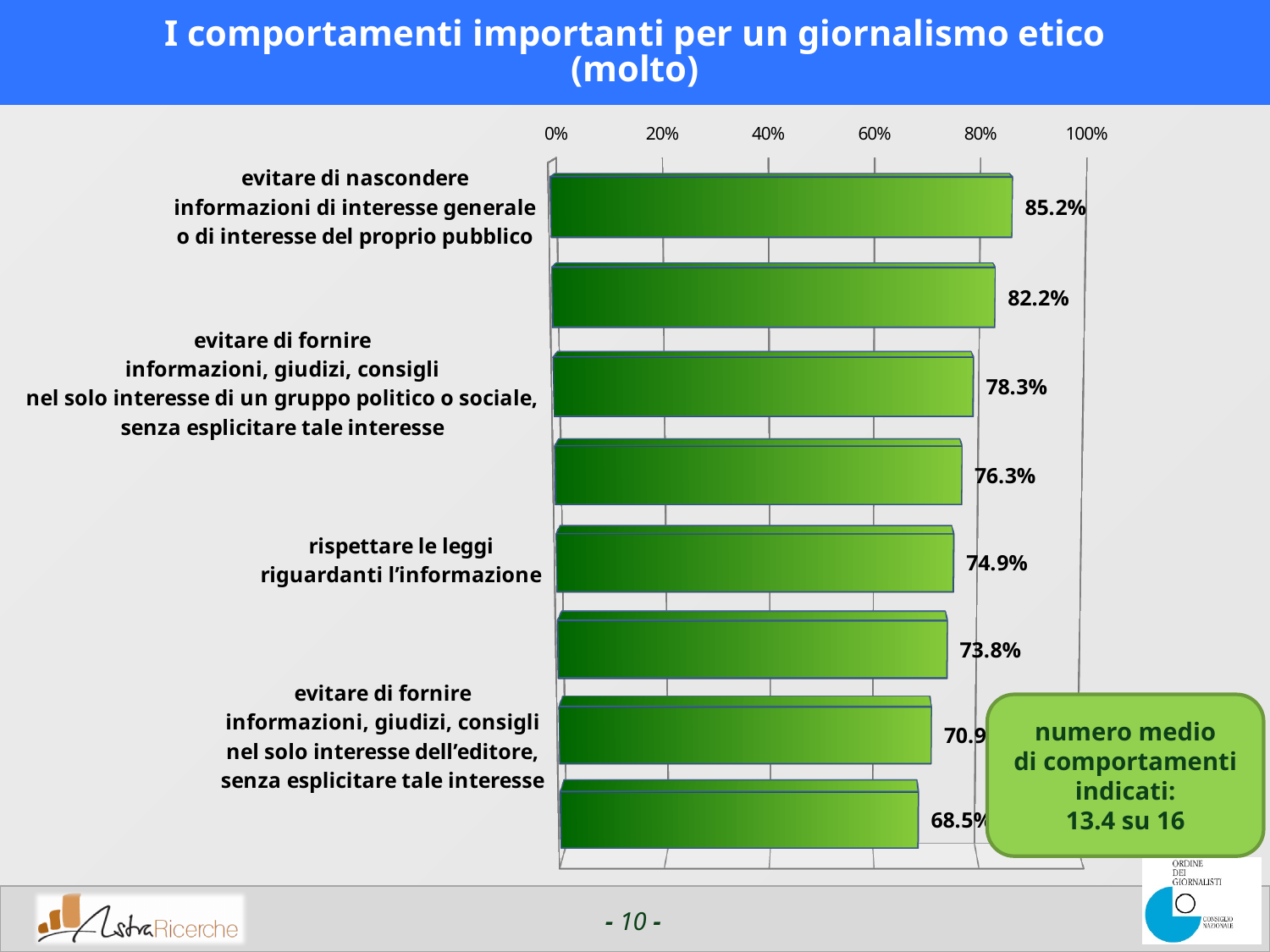
What percentage is shown for 'evitare di fornire informazioni, giudizi, consigli nel solo interesse dell'editore, senza esplicitare tale interesse'? 70.9% What percentage is shown for 'rispettare le leggi riguardanti l'informazione'? 74.9% Which is larger: the value for 'rispettare le leggi riguardanti l'informazione' or the value for 'evitare di fornire informazioni, giudizi, consigli nel solo interesse dell'editore, senza esplicitare tale interesse'? rispettare le leggi riguardanti l'informazione What percentage is shown for 'evitare di fornire informazioni, giudizi, consigli nel solo interesse di un gruppo politico o sociale, senza esplicitare tale interesse'? 78.3% What percentage is shown for 'evitare di nascondere informazioni di interesse generale o di interesse del proprio pubblico'? 85.2% According to the green callout box, what is the average number of behaviours indicated? 13.4 su 16 What is the highest value shown in the chart? 85.2% What kind of chart is shown on the slide? bar chart How many bars are plotted in the chart? 8 What is the difference between the value for 'evitare di nascondere informazioni di interesse generale o di interesse del proprio pubblico' and the value for 'rispettare le leggi riguardanti l'informazione'? 10.3 percentage points Do the bar values rise or fall going from the top of the chart to the bottom? fall What is the lowest value shown in the chart? 68.5%